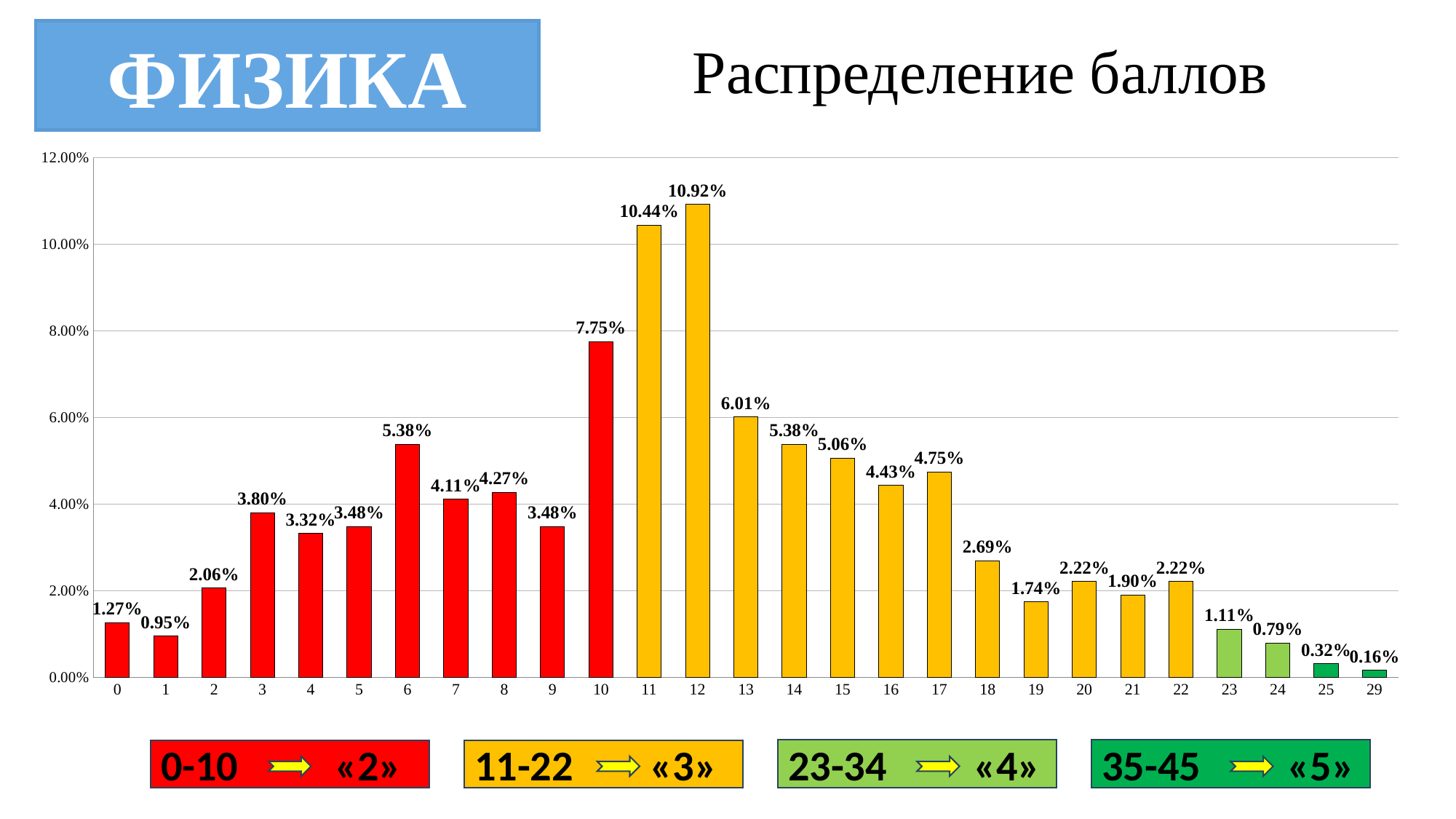
What type of chart is shown on the slide? bar chart How many bars are plotted in the chart? 27 Which score has the highest percentage? 12 Which is larger, the value for score 6 or the value for score 16? score 6 What is the value for score 0? 1.27% What is the value for score 10? 7.75% What is the value for score 12? 10.92% What is the difference between the values for score 12 and score 11? 0.48% What is the difference between the values for score 10 and score 13? 1.74% Which score has the lowest percentage? 29 What is the value for score 18? 2.69% What is the title of the chart? Распределение баллов